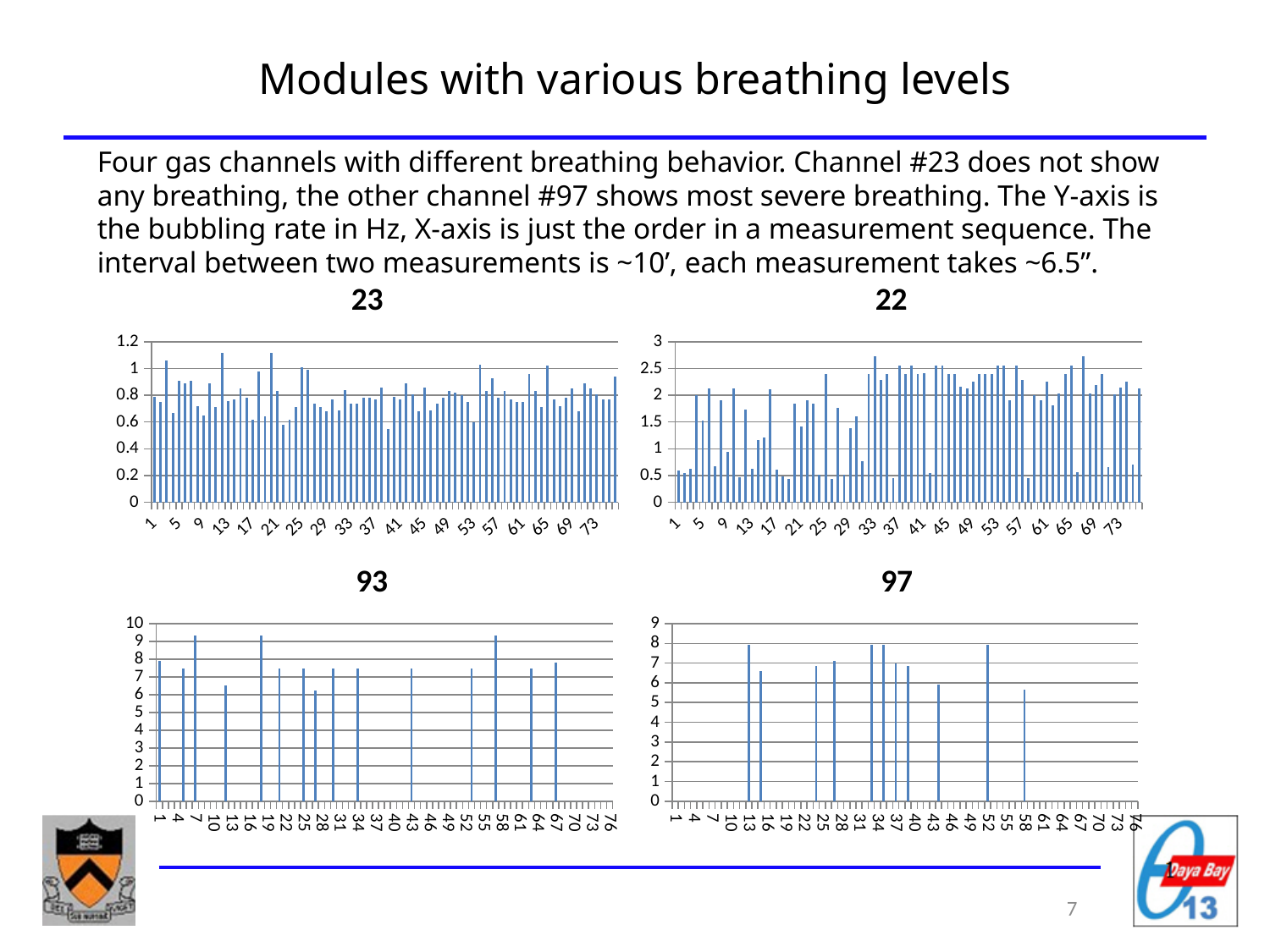
In the chart titled 23, is the value at x = 13 greater or less than 1? less In the chart titled 93, is the value at x = 13 greater or less than 7? less In the chart titled 97, is the value at x = 58 greater or less than 6? less What kind of chart is the chart titled 23? bar chart What is the highest value shown on the y-axis of the chart titled 22? 3 What is the title of the bottom-left chart? 93 How many charts are shown on the slide? 4